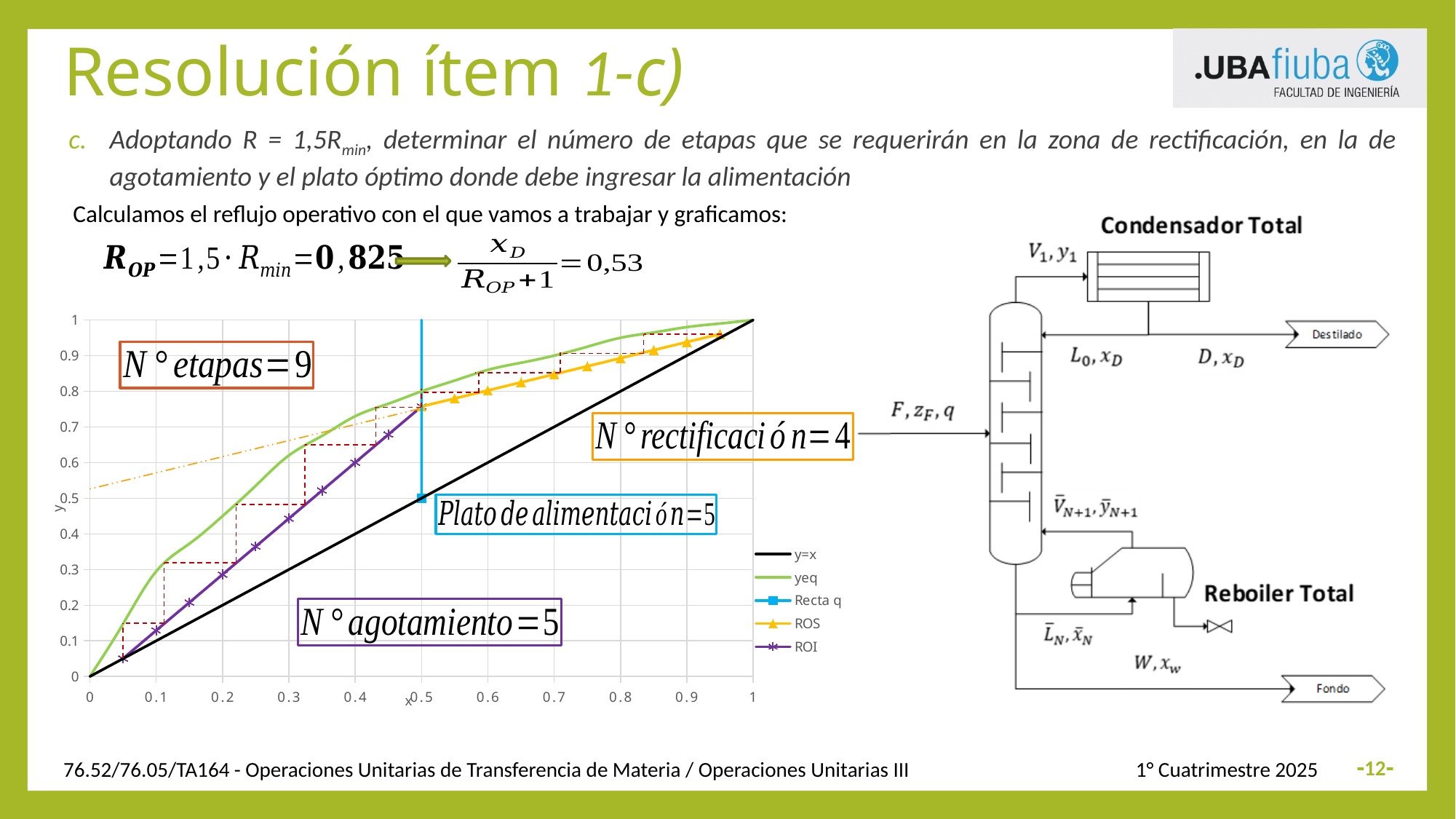
Does the yeq series rise or fall as x increases? rise Is the value of the ROI series at x = 0.3 greater or less than 0.5? less Is the value of the ROS series at x = 0.9 greater or less than 0.8? greater What is the maximum value shown on the chart's y axis? 1 At what x value is the vertical Recta q line located on the chart? 0.5 At x = 0.3, which series has the larger value, yeq or ROI? yeq At x = 0.7, which series has the larger value, ROS or y=x? ROS Is the value of the yeq series at x = 0.5 greater or less than 0.7? greater How many tick marks are labelled on the chart's x axis? 11 Which series are listed in the chart legend? y=x, yeq, Recta q, ROS, ROI What kind of chart is shown on the slide? line chart How many series does the chart legend list? 5